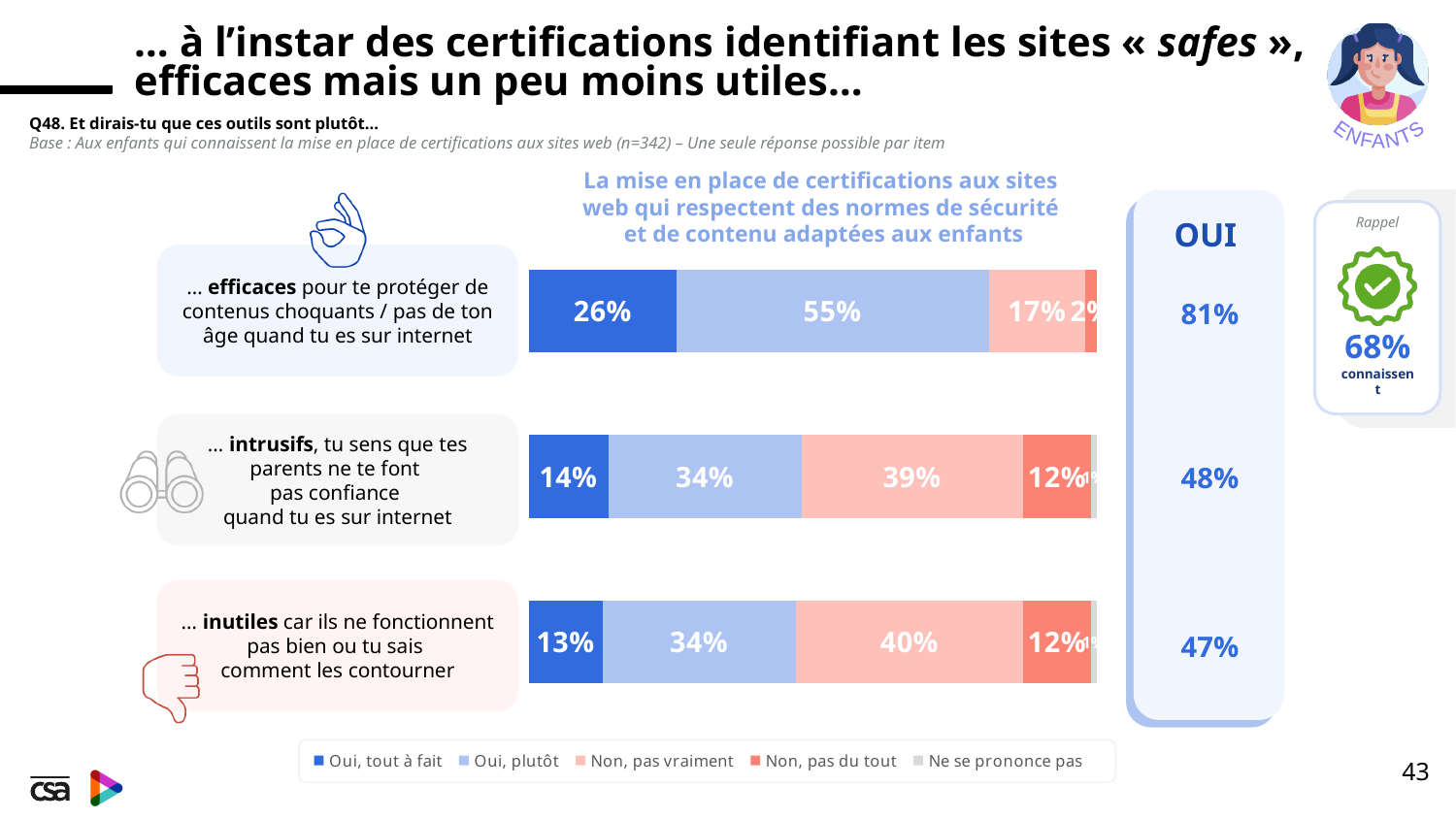
What percentage of children answered "Oui, tout à fait" that the certifications are efficaces? 26% What percentage answered "Non, pas du tout" for the item "inutiles"? 12% Which item has the lowest "Oui, tout à fait" percentage? inutiles What percentage answered "Non, pas vraiment" for the item "intrusifs"? 39% How many items (statements) are plotted in the chart? 3 Which item has the highest "OUI" total? efficaces What kind of chart is used to show the responses about the certifications? Stacked bar chart How many series does the chart legend list? 5 Which is larger: the "Non, pas vraiment" share for "inutiles" or for "intrusifs"? inutiles What is the difference between the "OUI" totals for "efficaces" and "intrusifs"? 33 points What is the total "OUI" percentage shown for the item "efficaces"? 81% What percentage answered "Oui, plutôt" for the item "efficaces"? 55%